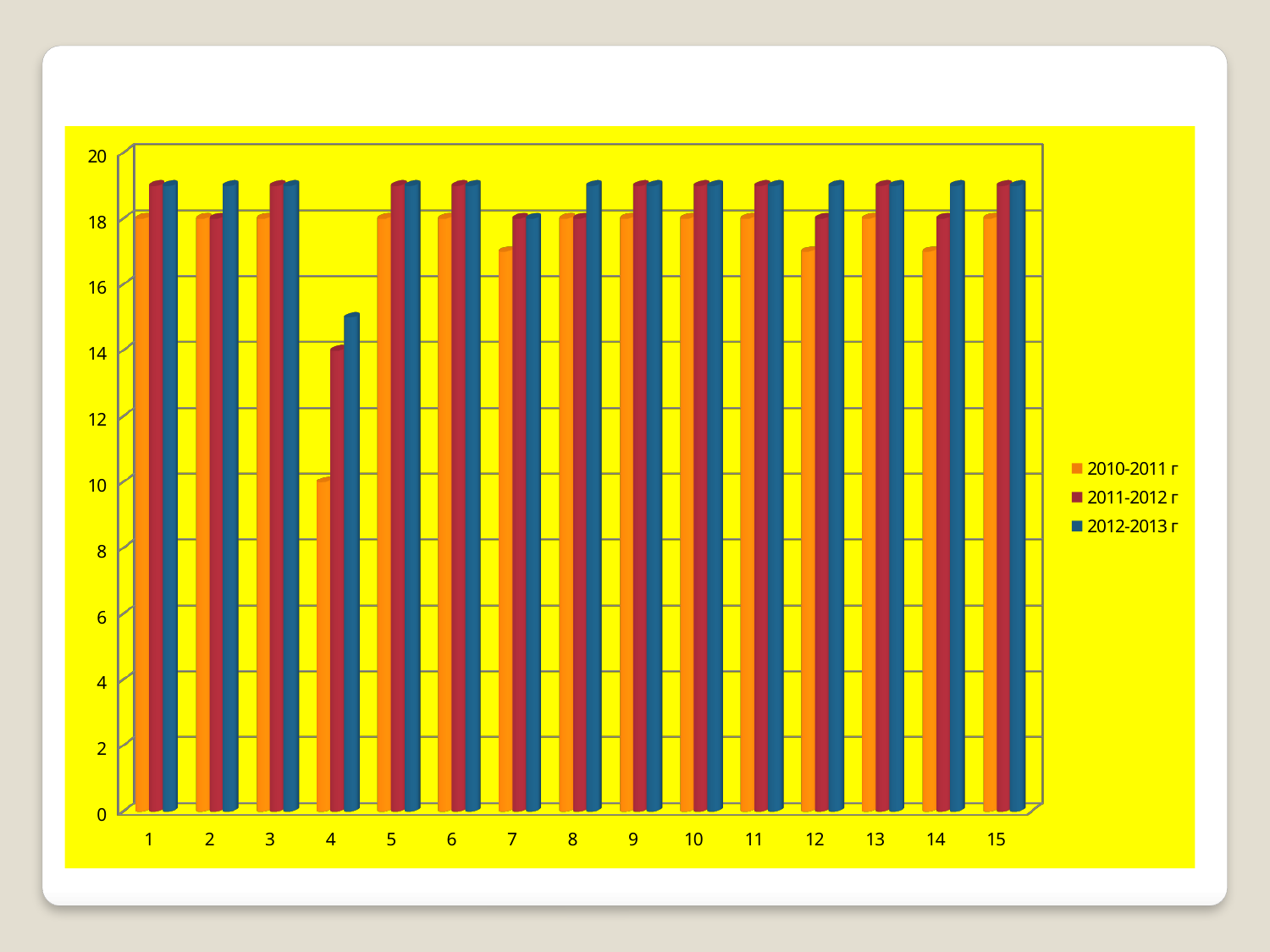
What kind of chart is shown on the slide? bar chart Which series is shown in blue? 2012-2013 г In the 2010-2011 г series, which has the larger value: category 1 or category 4? category 1 For category 4, which series has the larger value: 2010-2011 г or 2012-2013 г? 2012-2013 г Which series is listed first in the legend? 2010-2011 г How many categories are shown along the x axis? 15 Is the value for category 4 in the 2011-2012 г series greater or less than 12? greater How many series does the legend list? 3 Is the value for category 4 in the 2012-2013 г series greater or less than 16? less Is the value for category 4 in the 2010-2011 г series greater or less than 12? less Which category has the lowest value for the 2012-2013 г series? 4 Which category has the lowest value for the 2010-2011 г series? 4